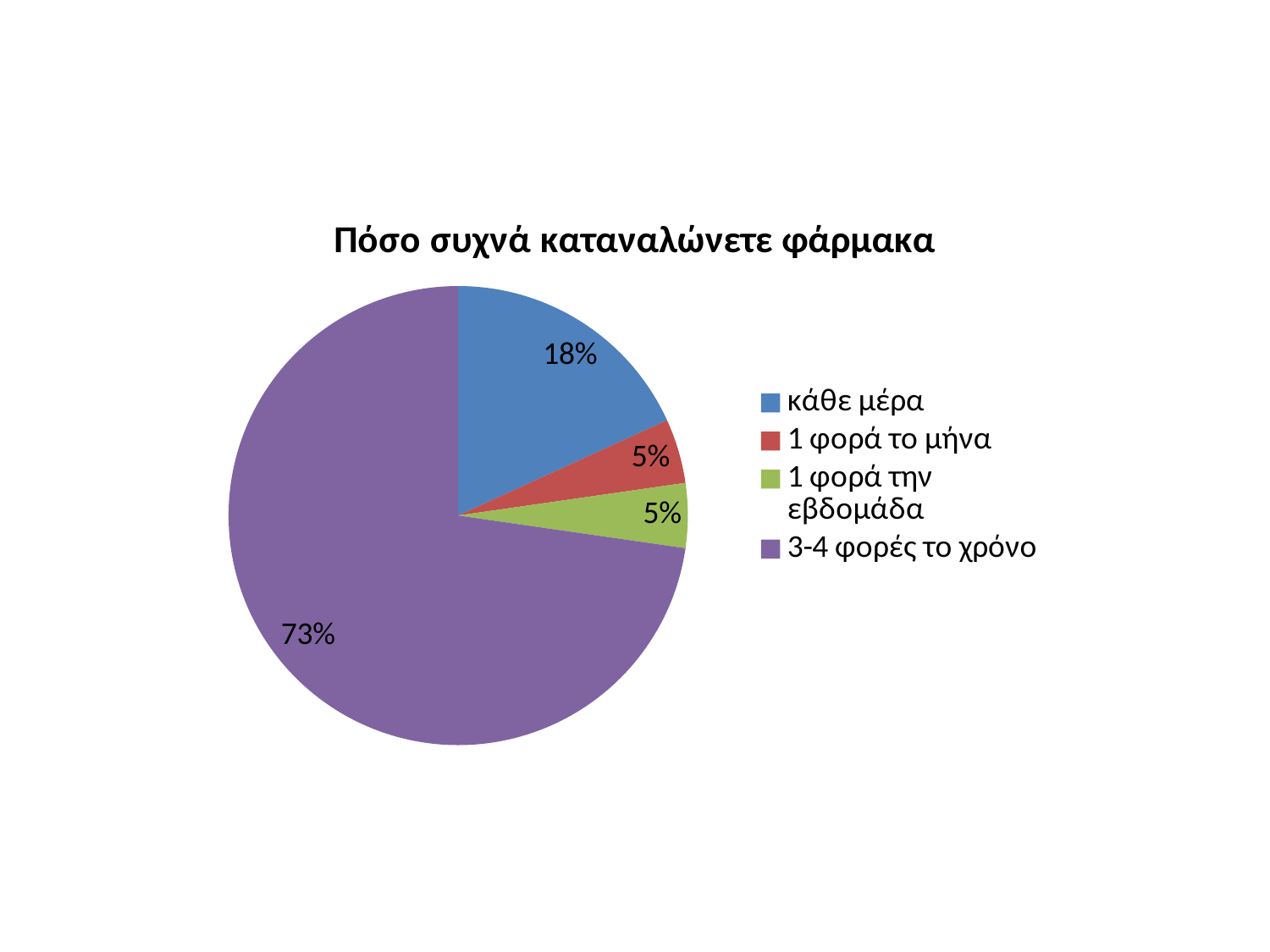
What percentage of the pie corresponds to '3-4 φορές το χρόνο'? 73% What is the title of the chart? Πόσο συχνά καταναλώνετε φάρμακα What is the difference in percentage points between '3-4 φορές το χρόνο' and 'κάθε μέρα'? 55 What percentage of the pie corresponds to '1 φορά το μήνα'? 5% What colour is the slice for '3-4 φορές το χρόνο'? purple What is the combined share of 'κάθε μέρα' and '1 φορά το μήνα'? 23% What type of chart is shown on the slide? pie chart Which is larger, the share for 'κάθε μέρα' or the share for '1 φορά το μήνα'? κάθε μέρα How many categories does the legend list? 4 Which category has the largest share of the pie? 3-4 φορές το χρόνο What percentage of the pie corresponds to '1 φορά την εβδομάδα'? 5% What percentage of the pie corresponds to 'κάθε μέρα'? 18%